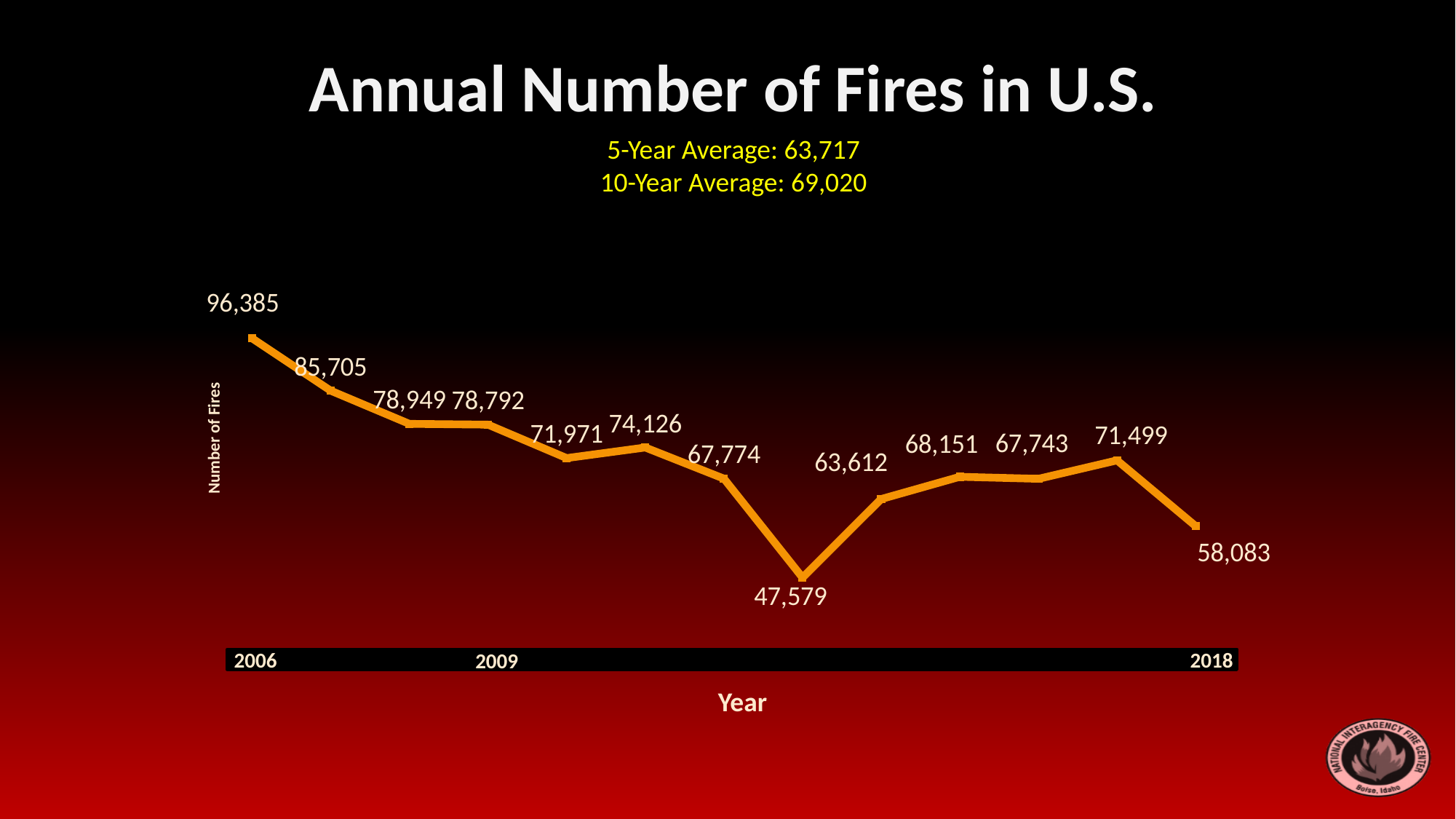
What is the highest annual number of fires shown on the chart? 96,385 How many data points are plotted on the line? 13 What is the difference between the number of fires in 2006 and in 2018? 38,302 Which year has the highest number of fires? 2006 What is the 10-Year Average stated on the slide? 69,020 What is the number of fires in 2006? 96,385 What is the lowest annual number of fires shown on the chart? 47,579 Which is larger, the number of fires in 2009 or in 2018? 2009 What is the number of fires in 2018? 58,083 What is the number of fires in 2009? 78,792 What type of chart is shown on the slide? line chart What is the difference between the highest and lowest annual number of fires on the chart? 48,806